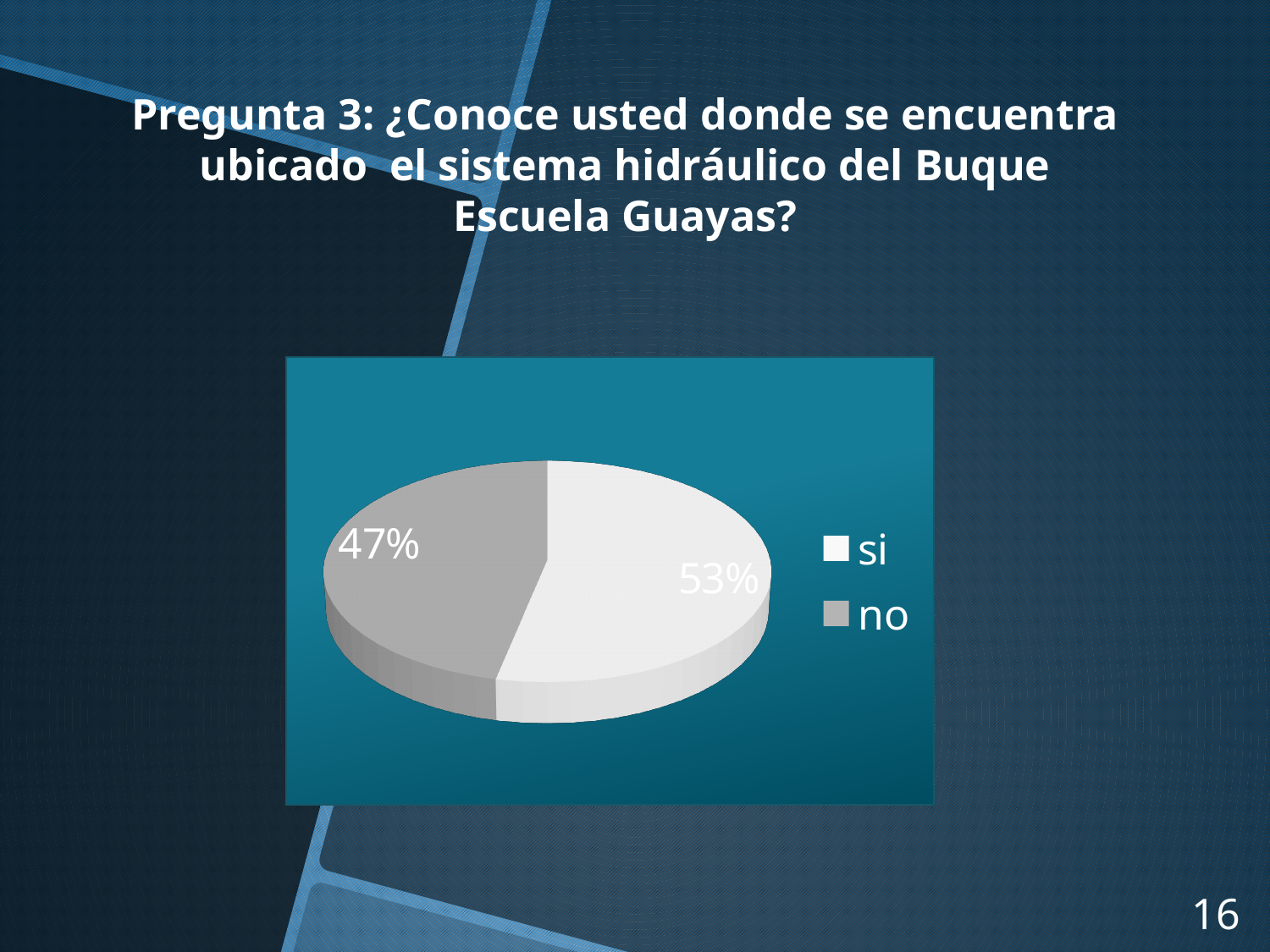
Which legend entry is shown in the darker grey colour? no Is the share for "si" greater or less than 50%? greater Which is larger, the "si" slice or the "no" slice? si What is the difference in percentage points between the "si" and "no" slices? 6 Is the share for "no" greater or less than 50%? less How many entries does the legend list? 2 Which slice is the smallest in the pie chart? no What share of the pie does the "si" slice represent? 53% What share of the pie does the "no" slice represent? 47% What kind of chart is shown on the slide? pie chart Which slice is the largest in the pie chart? si How many slices does the pie chart have? 2